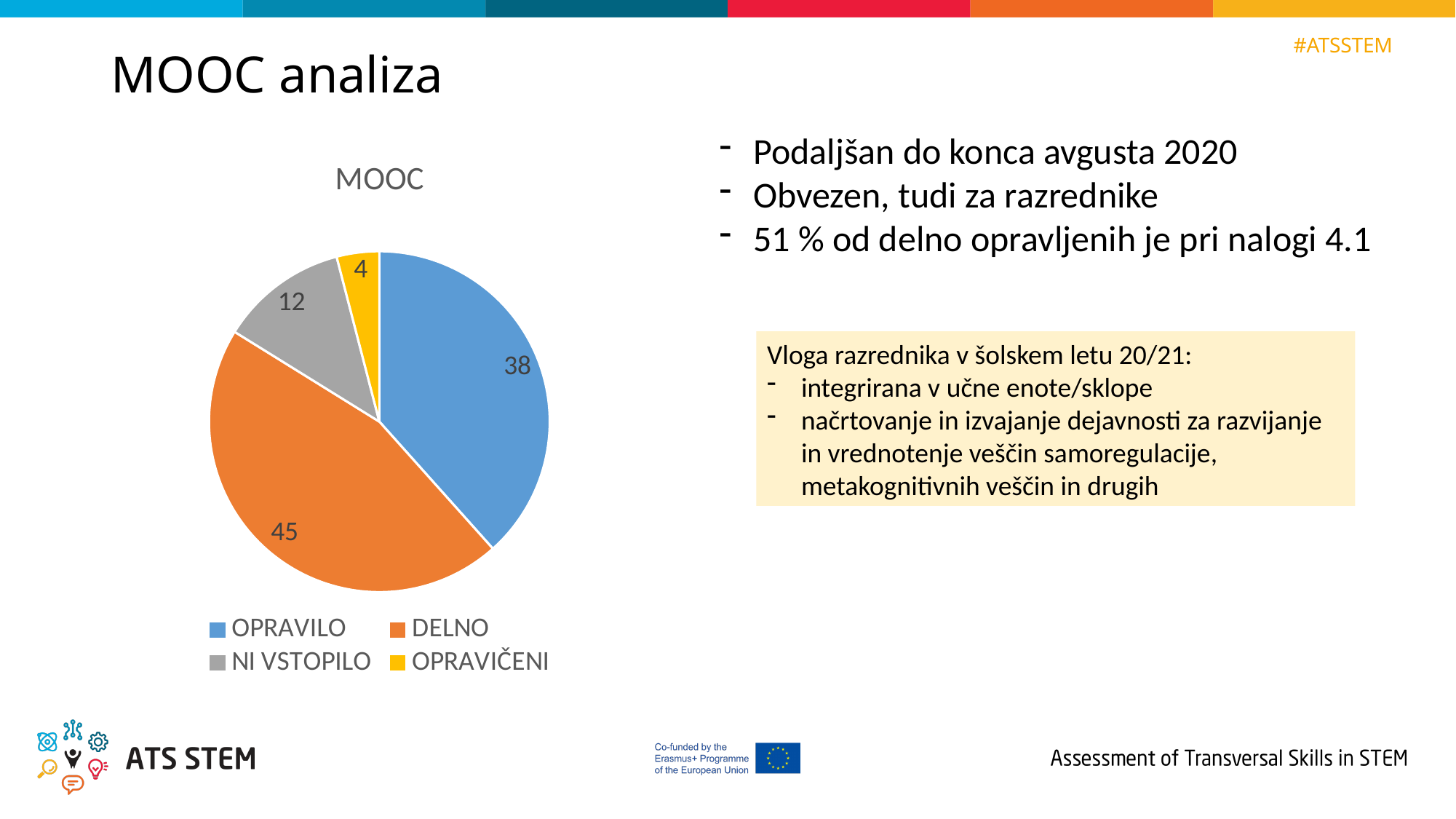
Which category has the largest slice in the pie chart? DELNO Which category has the smallest slice in the pie chart? OPRAVIČENI Which is larger, the value for NI VSTOPILO or the value for OPRAVIČENI? NI VSTOPILO How many categories does the pie chart have? 4 What is the value for NI VSTOPILO in the pie chart? 12 What type of chart is shown on the slide? pie chart Which colour represents NI VSTOPILO in the pie chart? gray What is the value for DELNO in the pie chart? 45 What is the title of the chart? MOOC What is the difference between the values for DELNO and OPRAVILO? 7 What is the value for OPRAVIČENI in the pie chart? 4 What is the value for OPRAVILO in the pie chart? 38